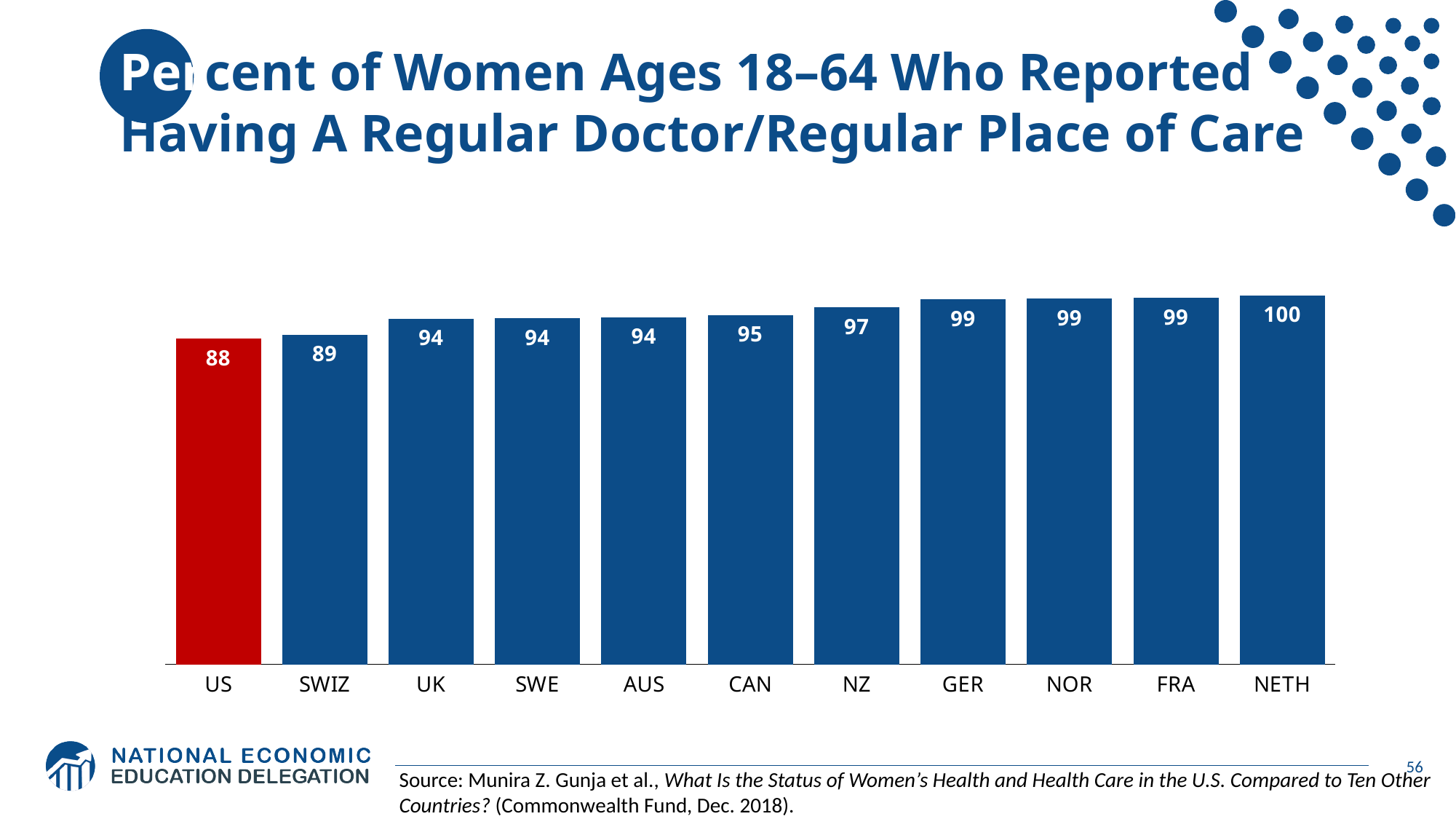
Which is larger, the value for SWIZ or the value for CAN? CAN What is the value for the US? 88 What is the difference between the values for SWIZ and UK? 5 What is the value for CAN? 95 What is the value for NZ? 97 What kind of chart is shown on the slide? bar chart What is the difference between the values for NETH and the US? 12 Which bar is coloured red rather than blue? US Which country has the lowest value? US Which country has the highest value? NETH Do the values rise or fall moving from left to right along the x axis? rise How many countries are shown in the chart? 11